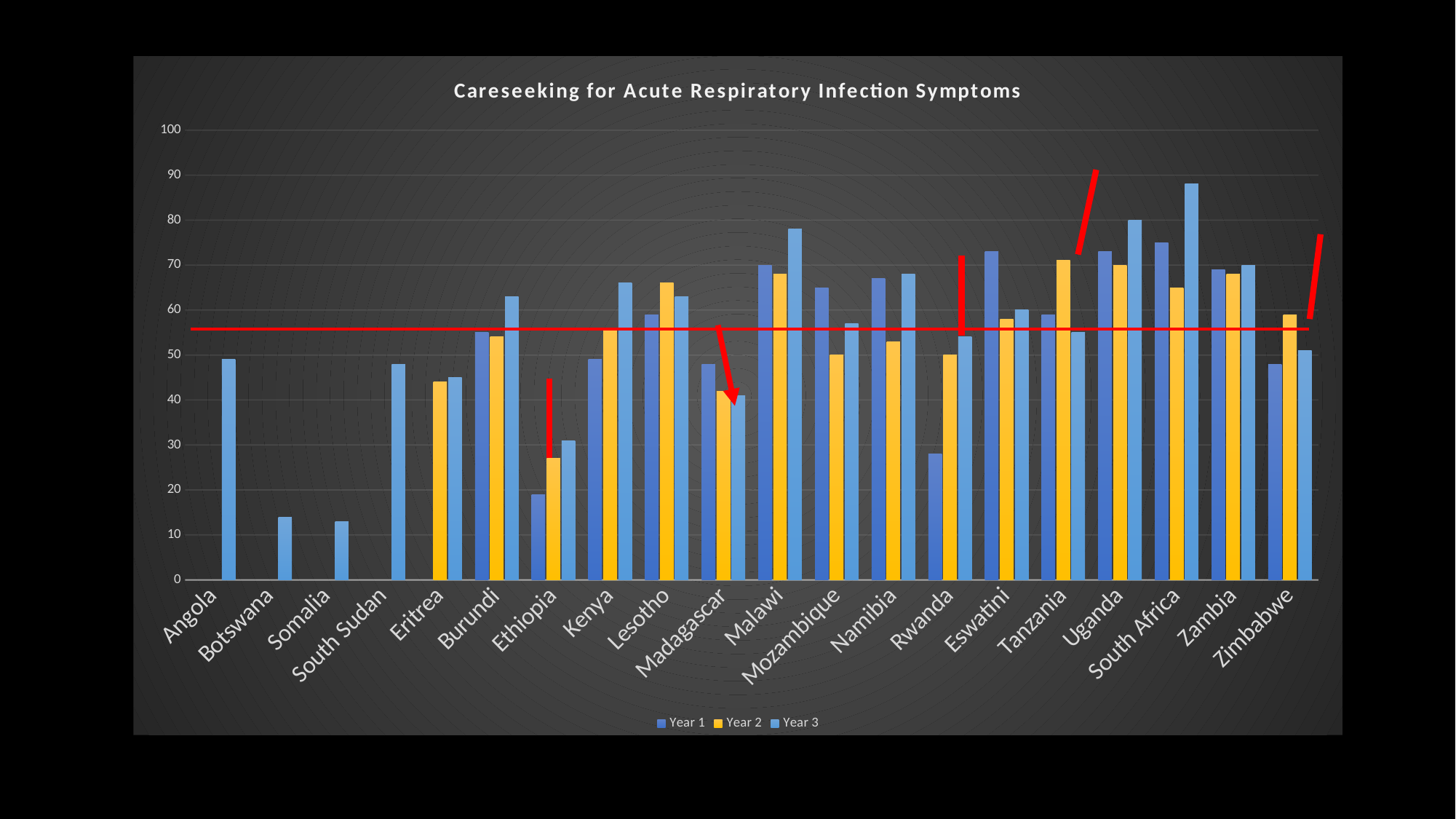
What type of chart is shown on the slide? Bar chart How many series does the legend list? 3 Which country has the lowest Year 1 value? Ethiopia Is the Year 3 value for South Africa greater or less than 80? greater How many countries are shown on the x axis? 20 What is the title of the chart? Careseeking for Acute Respiratory Infection Symptoms Which is larger, the Year 3 value for South Africa or the Year 3 value for Uganda? South Africa Is the Year 1 value for Rwanda greater or less than 30? less Which is larger for Kenya, the Year 1 value or the Year 3 value? Year 3 Is the Year 3 value for Malawi greater or less than 70? greater Which country has the highest Year 3 value? South Africa